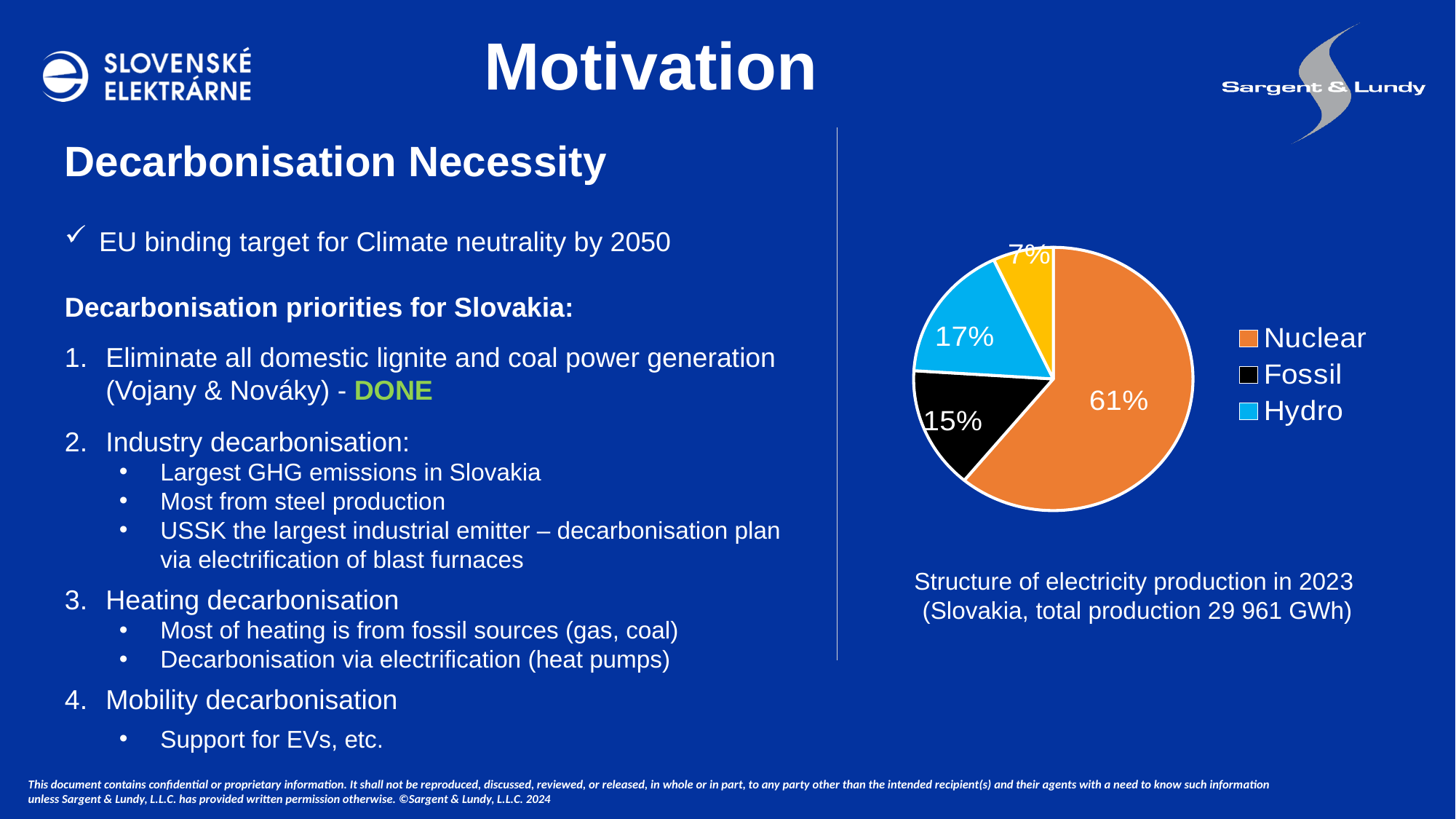
What kind of chart is shown on the slide? pie chart What total electricity production is stated in the caption below the pie chart? 29 961 GWh Which is larger, the share for Hydro or the share for Fossil? Hydro What share of electricity production in 2023 does Nuclear account for? 61% What share of electricity production in 2023 does Fossil account for? 15% Which source has the largest share of electricity production in the pie chart? Nuclear What is the difference in percentage points between the Hydro share and the Fossil share? 2 What colour is the Nuclear slice in the pie chart? orange What share of electricity production in 2023 does Hydro account for? 17% How many entries does the legend of the pie chart list? 3 What is the difference in percentage points between the Nuclear share and the Hydro share? 44 How many slices does the pie chart have? 4